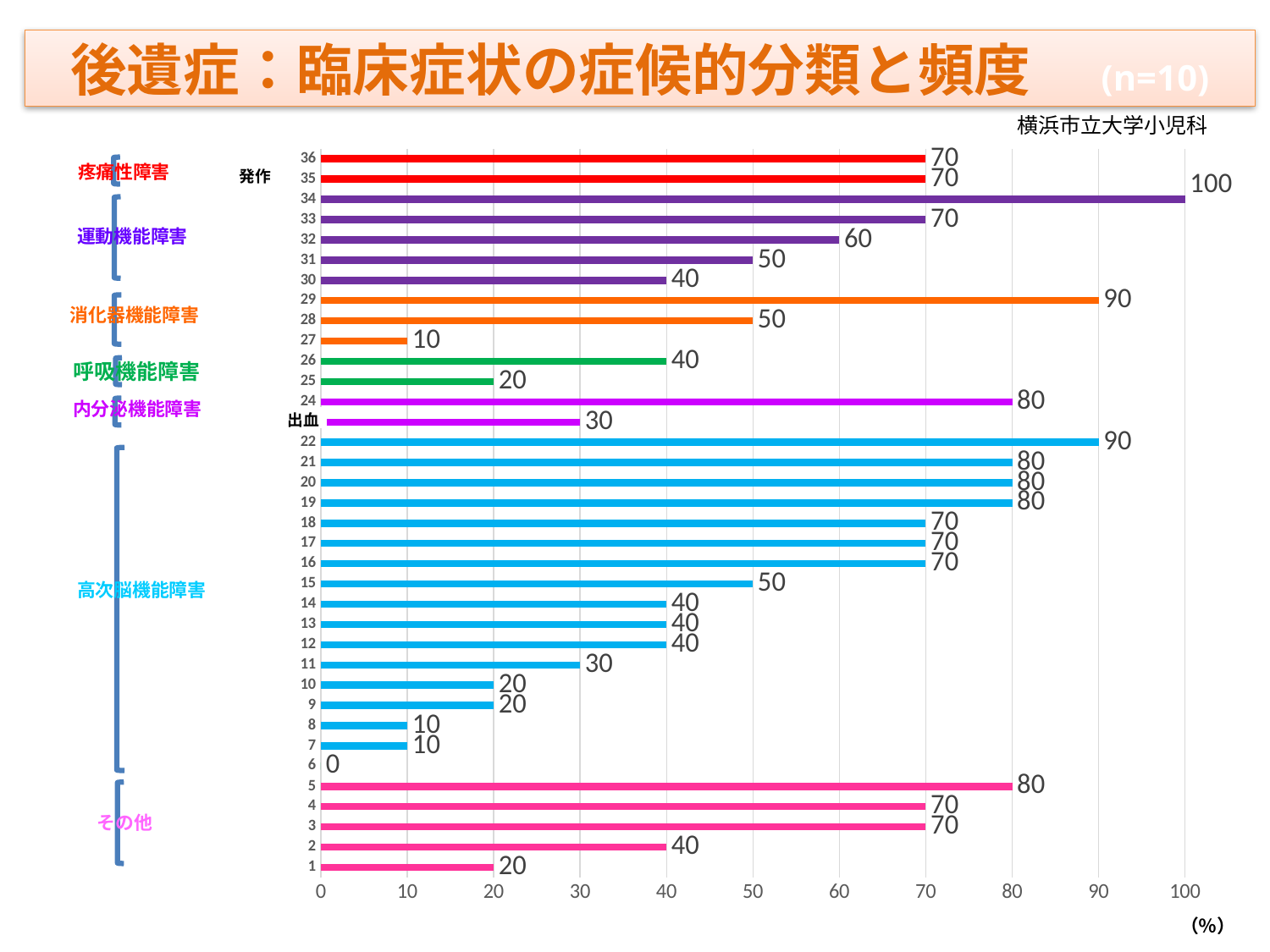
What unit is shown at the bottom right of the x axis? (%) What type of chart is shown on the slide? bar chart Which has a larger value, category 32 or category 30? 32 How many categories are plotted on the chart? 36 What is the difference between the values for category 22 and category 15? 40 What is the value for category 34? 100 What is the value for the category labelled 出血? 30 What is the value for category 27? 10 Which category has the lowest value? 6 What is the value for category 5? 80 What is the value for category 29? 90 Which category has the highest value? 34